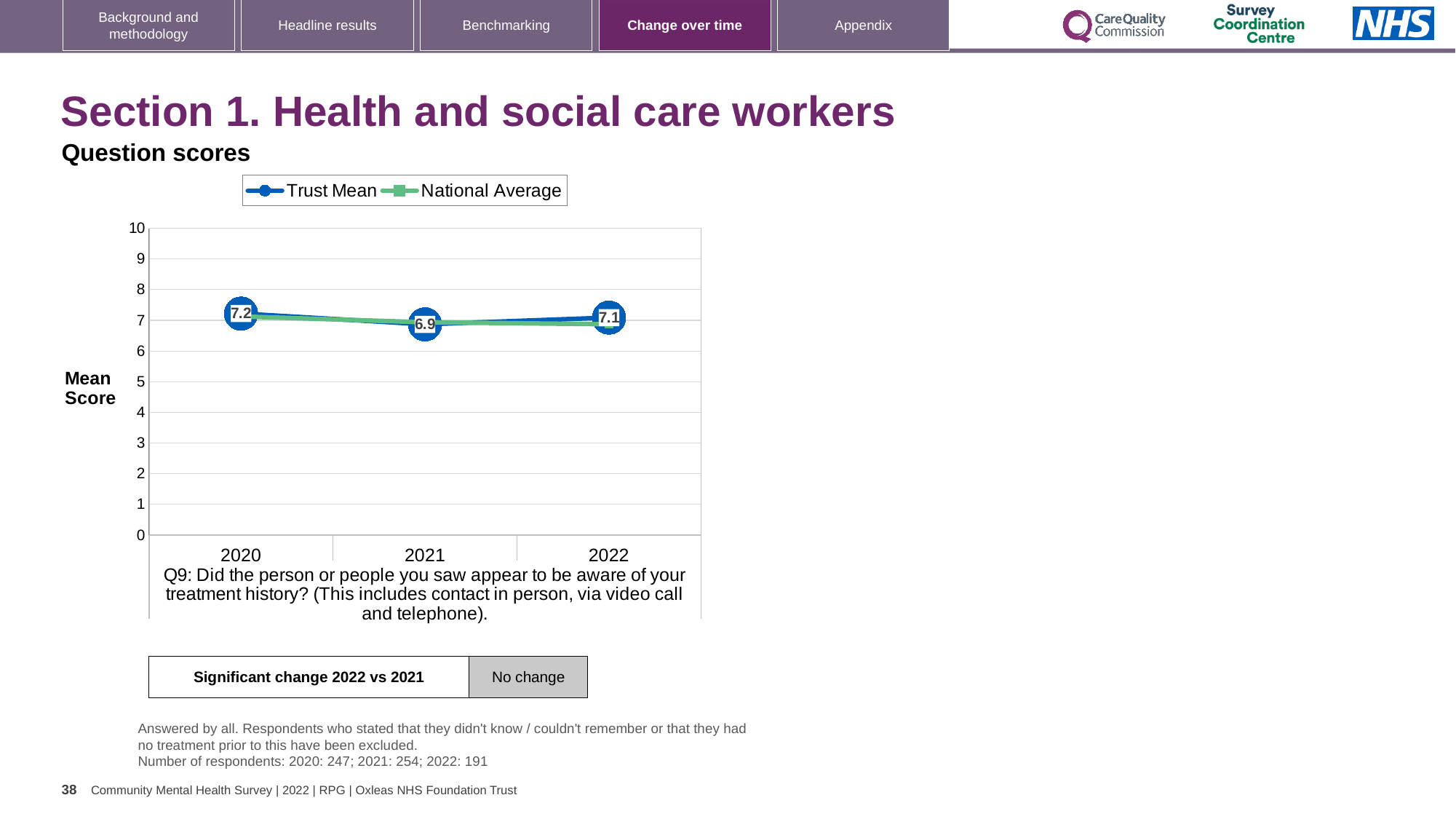
How many years are plotted on the x axis? 3 Did the Trust Mean score rise or fall from 2020 to 2021? Fall Is the National Average value for 2021 greater or less than 5? greater What is the Trust Mean score for 2022? 7.1 How many series does the legend list? 2 What is the Trust Mean score for 2020? 7.2 What kind of chart is shown on the slide? Line chart What is the Trust Mean score for 2021? 6.9 What is the difference between the Trust Mean scores for 2020 and 2021? 0.3 In which year was the Trust Mean score lowest? 2021 Which year has the larger Trust Mean score, 2020 or 2022? 2020 In which year was the Trust Mean score highest? 2020